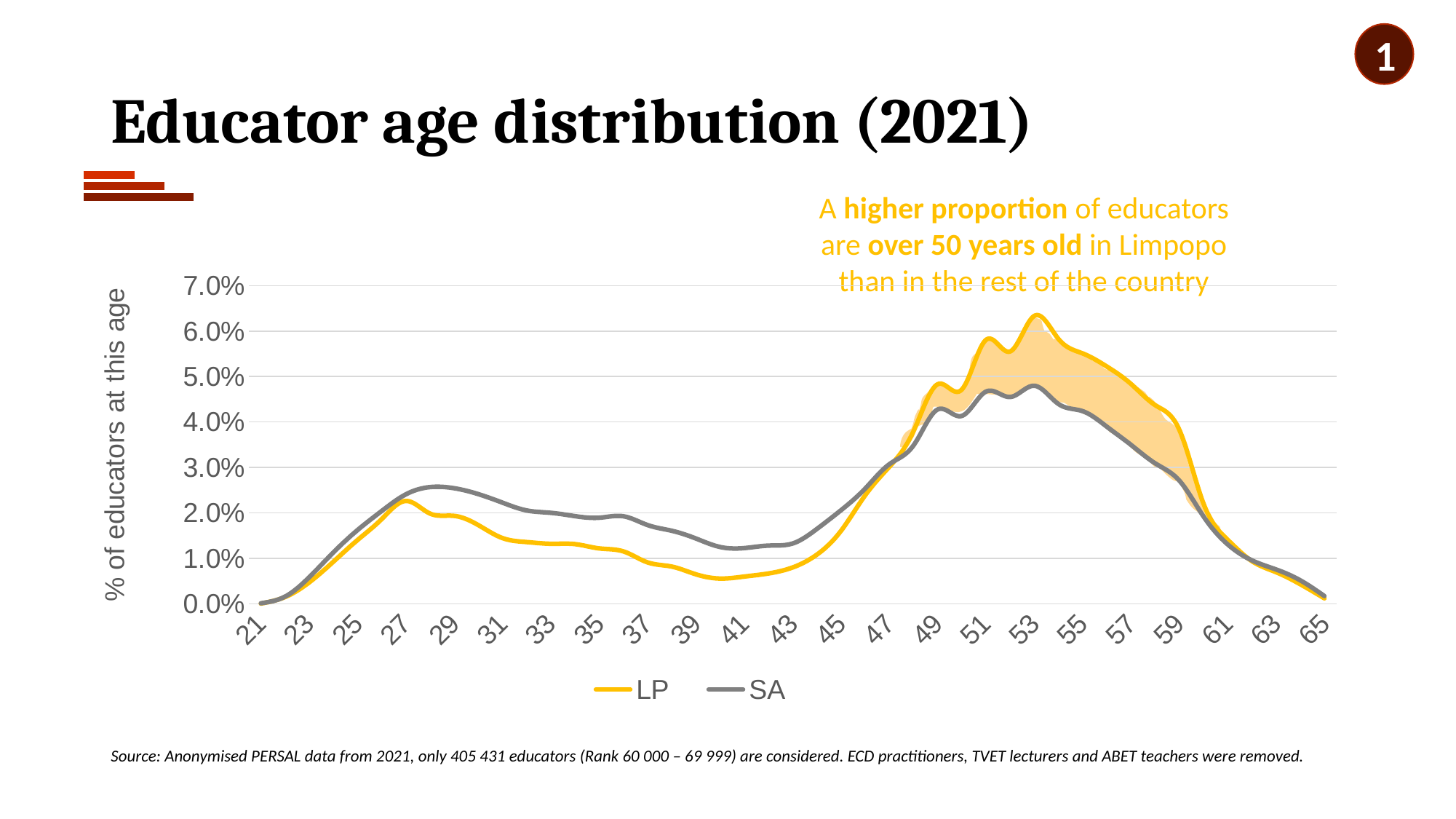
Is the LP value at age 53 greater or less than 6.0%? greater At age 31, which series has the higher value, LP or SA? SA What kind of chart is shown on the slide? line chart Is the LP value at age 41 greater or less than 1.0%? less Does the SA line rise or fall between age 41 and age 53? rise How many series does the legend list? 2 At age 55, which series has the higher value, LP or SA? LP What are the two series named in the legend? LP and SA What is the label on the vertical axis? % of educators at this age At which age does the LP line reach its highest value? 53 Does the LP line rise or fall between age 53 and age 65? fall Is the SA value at age 29 greater or less than 2.0%? greater